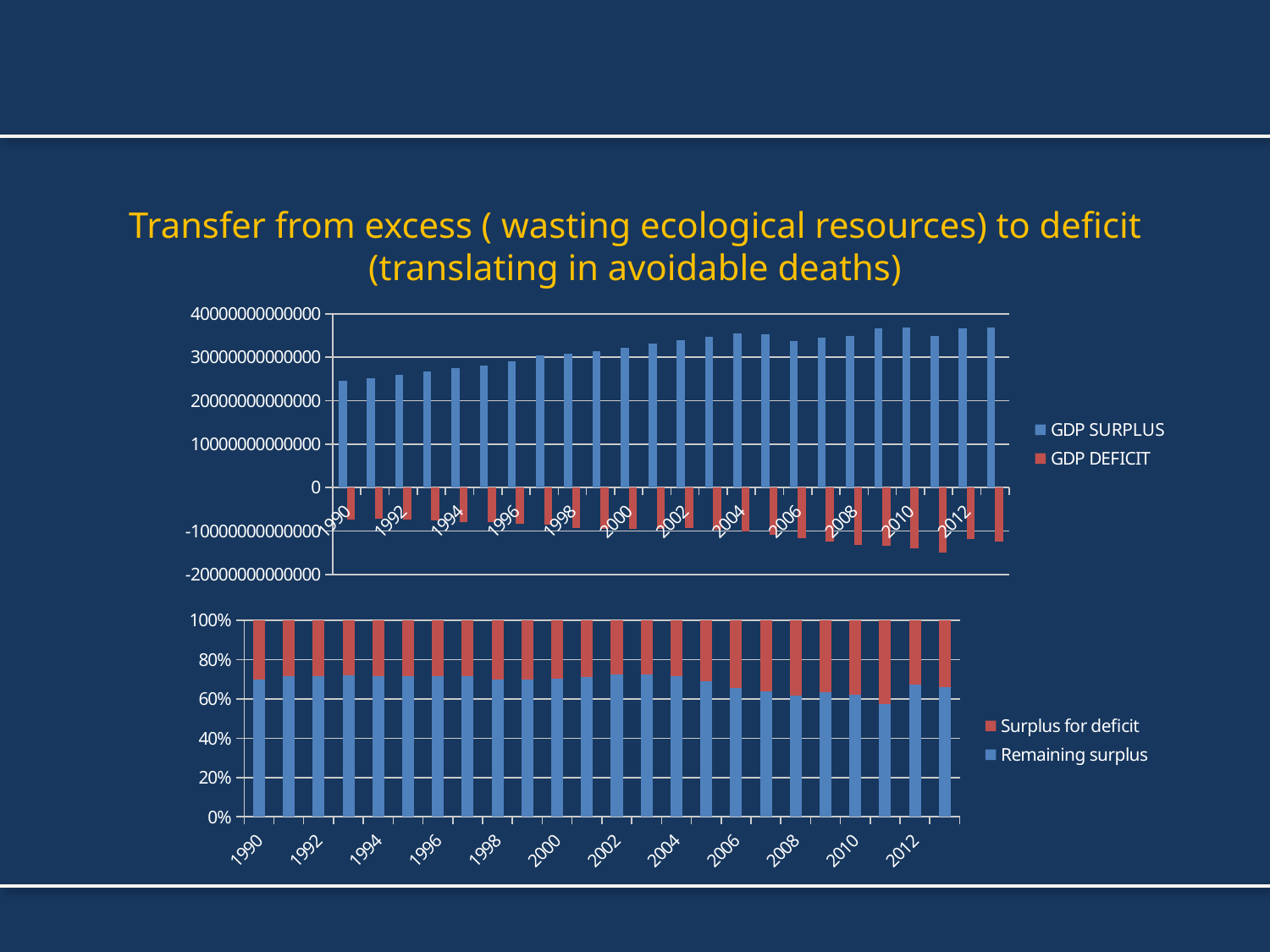
In the top chart, how many years (bars per series) are plotted? 24 In the bottom chart, which year has the lowest Remaining surplus share? 2011 In the top chart, how many series does the legend list? 2 In the bottom chart, what are the two series named in the legend? Surplus for deficit and Remaining surplus What kind of chart is the top chart on the slide? bar chart In the top chart, is the GDP DEFICIT value for 1990 greater or less than -10000000000000? greater In the top chart, is the GDP SURPLUS value for 2012 greater or less than 30000000000000? greater In the top chart, which is larger, the GDP SURPLUS for 1990 or for 2012? 2012 In the top chart, does GDP SURPLUS generally rise or fall from 1990 to 2013? rise In the top chart, is the GDP SURPLUS value for 1990 greater or less than 30000000000000? less What kind of chart is the bottom chart on the slide? stacked bar chart